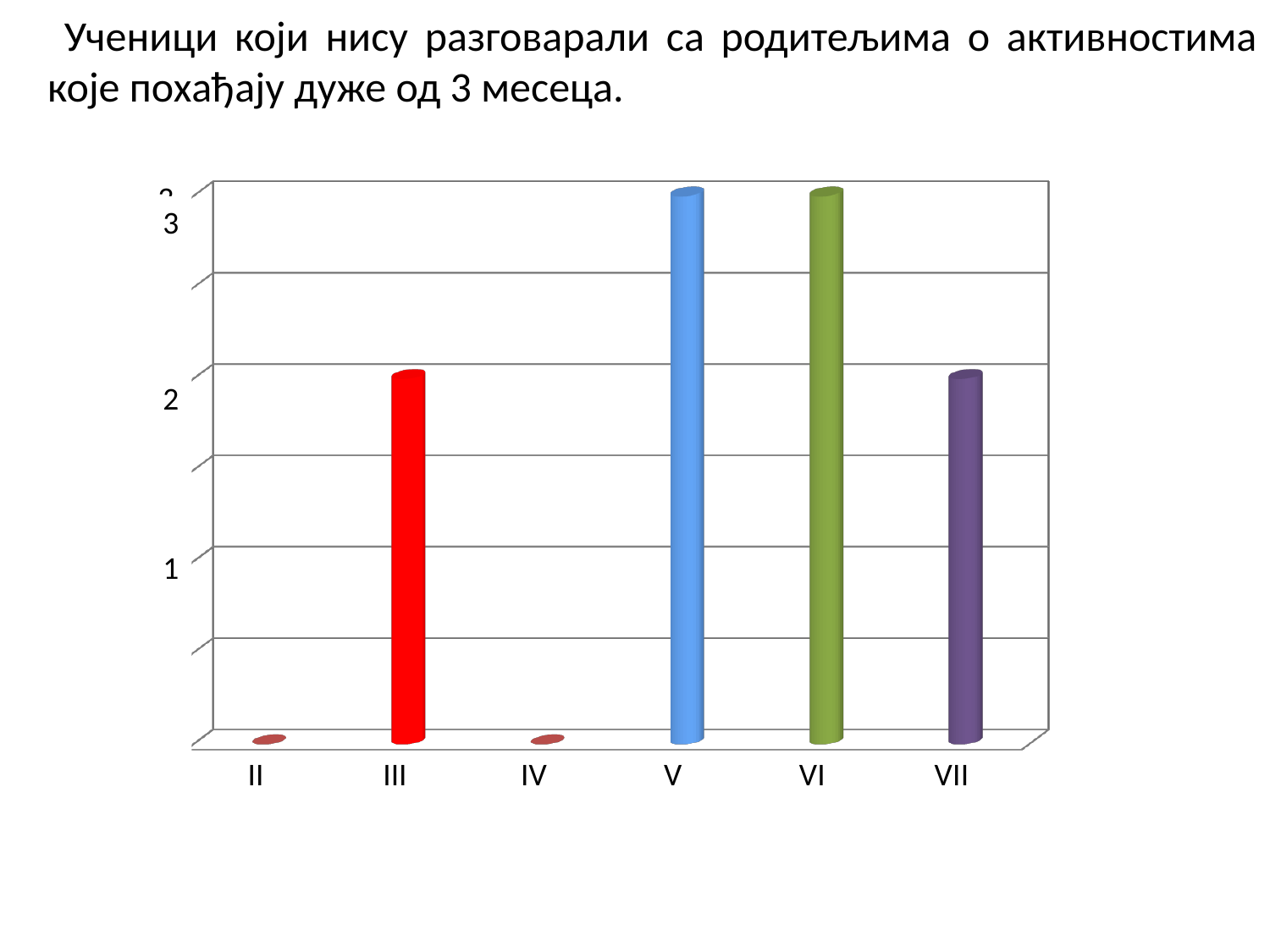
Is the value for category II greater or less than 1? less What is the value for category III? 2 What is the difference between the values for V and VII? 1 What is the value for category VII? 2 What is the value for category VI? 3 What is the value for category V? 3 Which is larger, the value for V or the value for III? V What colour is the bar for category III? red Which is larger, the value for VII or the value for VI? VI How many categories are shown on the x axis of the chart? 6 What kind of chart is shown on the slide? bar chart Is the value for category IV greater or less than 1? less